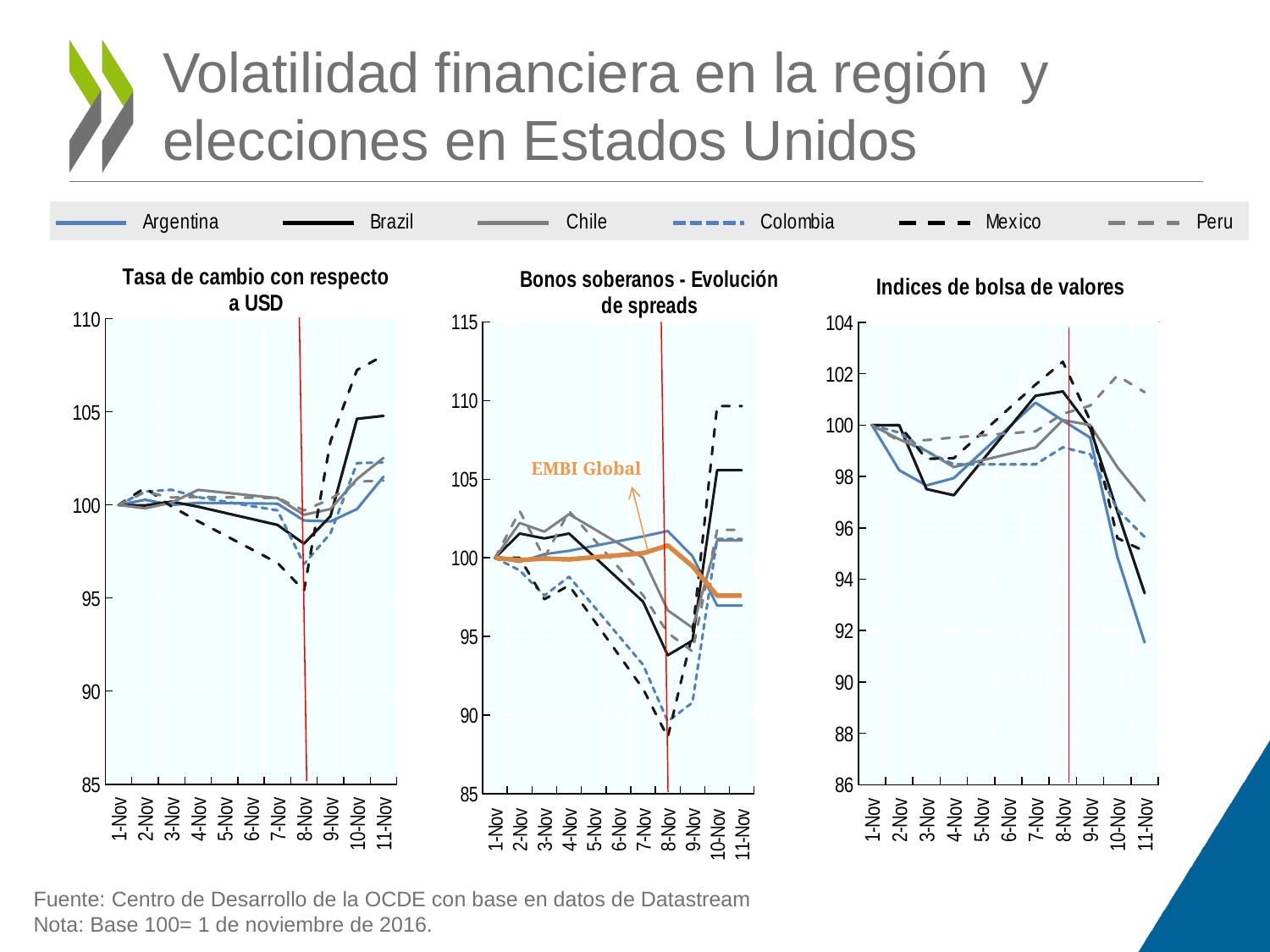
In the 'Bonos soberanos - Evolución de spreads' chart, which country has the lowest value on 8-Nov? Mexico How many series does the shared legend at the top of the slide list? 6 In the 'Bonos soberanos - Evolución de spreads' chart, which additional series, not in the shared legend, is labelled in orange? EMBI Global In the 'Tasa de cambio con respecto a USD' chart, which country has the highest value on 11-Nov? Mexico In the 'Tasa de cambio con respecto a USD' chart, is the value for Brazil on 8-Nov greater or less than 100? less In the 'Indices de bolsa de valores' chart, does the Argentina line rise or fall from 8-Nov to 11-Nov? fall In the 'Indices de bolsa de valores' chart, which country has the lowest value on 11-Nov? Argentina How many dates are shown on the x axis of the 'Indices de bolsa de valores' chart? 11 What kind of chart is the 'Tasa de cambio con respecto a USD' chart? line chart In the 'Bonos soberanos - Evolución de spreads' chart, is the value for Mexico on 8-Nov greater or less than 90? less In the 'Indices de bolsa de valores' chart, what value do all the series take on 1-Nov? 100 In the 'Tasa de cambio con respecto a USD' chart, is the value for Mexico on 11-Nov greater or less than 105? greater